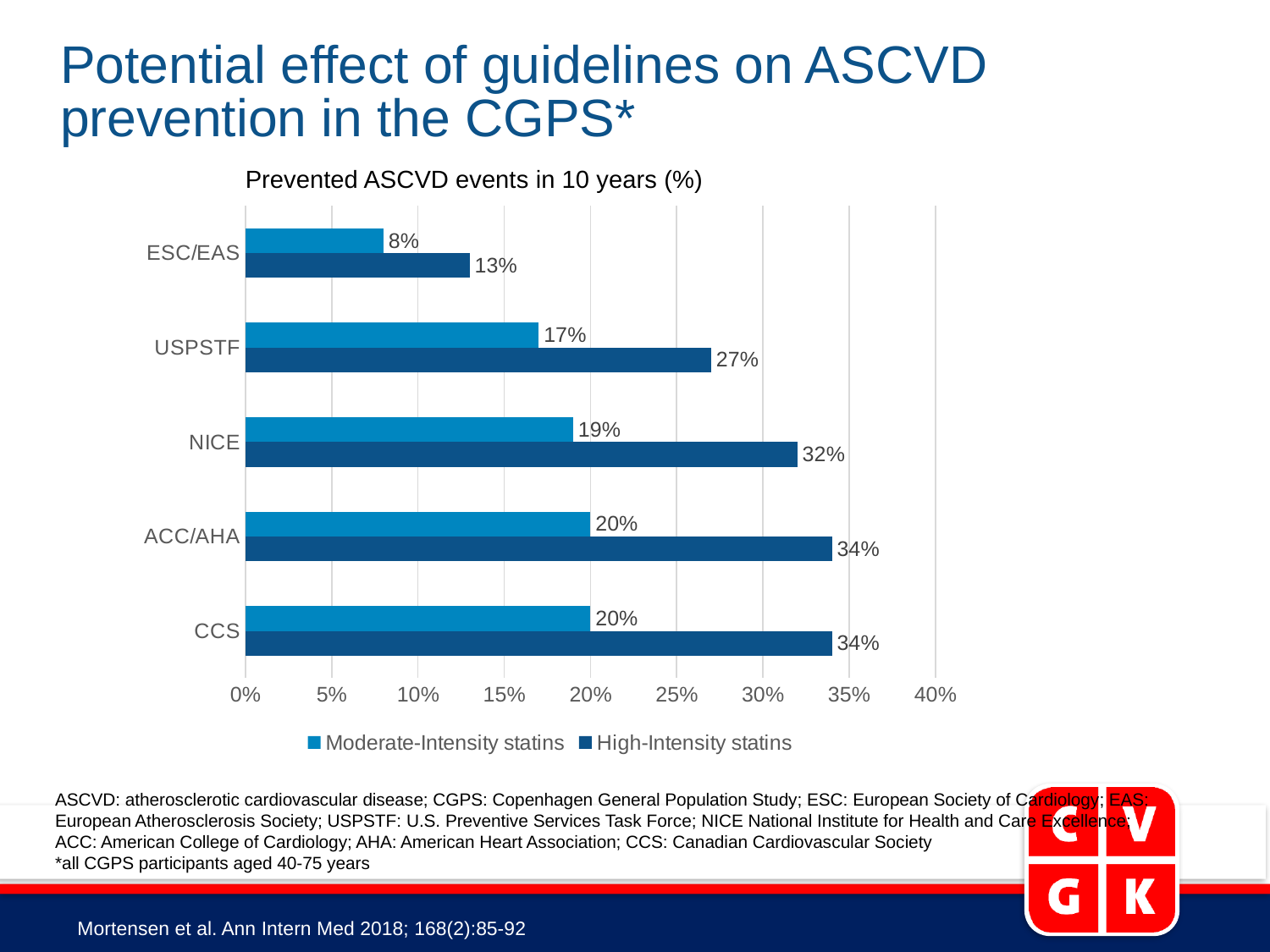
How many guidelines (categories) are shown on the chart? 5 What is the title of the chart? Prevented ASCVD events in 10 years (%) Which is larger: the Moderate-Intensity statins value for NICE or for USPSTF? NICE What is the value for High-Intensity statins for USPSTF? 27% Which guideline has the lowest value for High-Intensity statins? ESC/EAS What is the difference between the High-Intensity statins and Moderate-Intensity statins values for ACC/AHA? 14% What is the difference between the High-Intensity statins values for NICE and USPSTF? 5% How many series does the legend list? 2 What kind of chart is shown on the slide? Bar chart What is the value for High-Intensity statins for NICE? 32% What is the value for Moderate-Intensity statins for ESC/EAS? 8% Which guideline has the lowest value for Moderate-Intensity statins? ESC/EAS